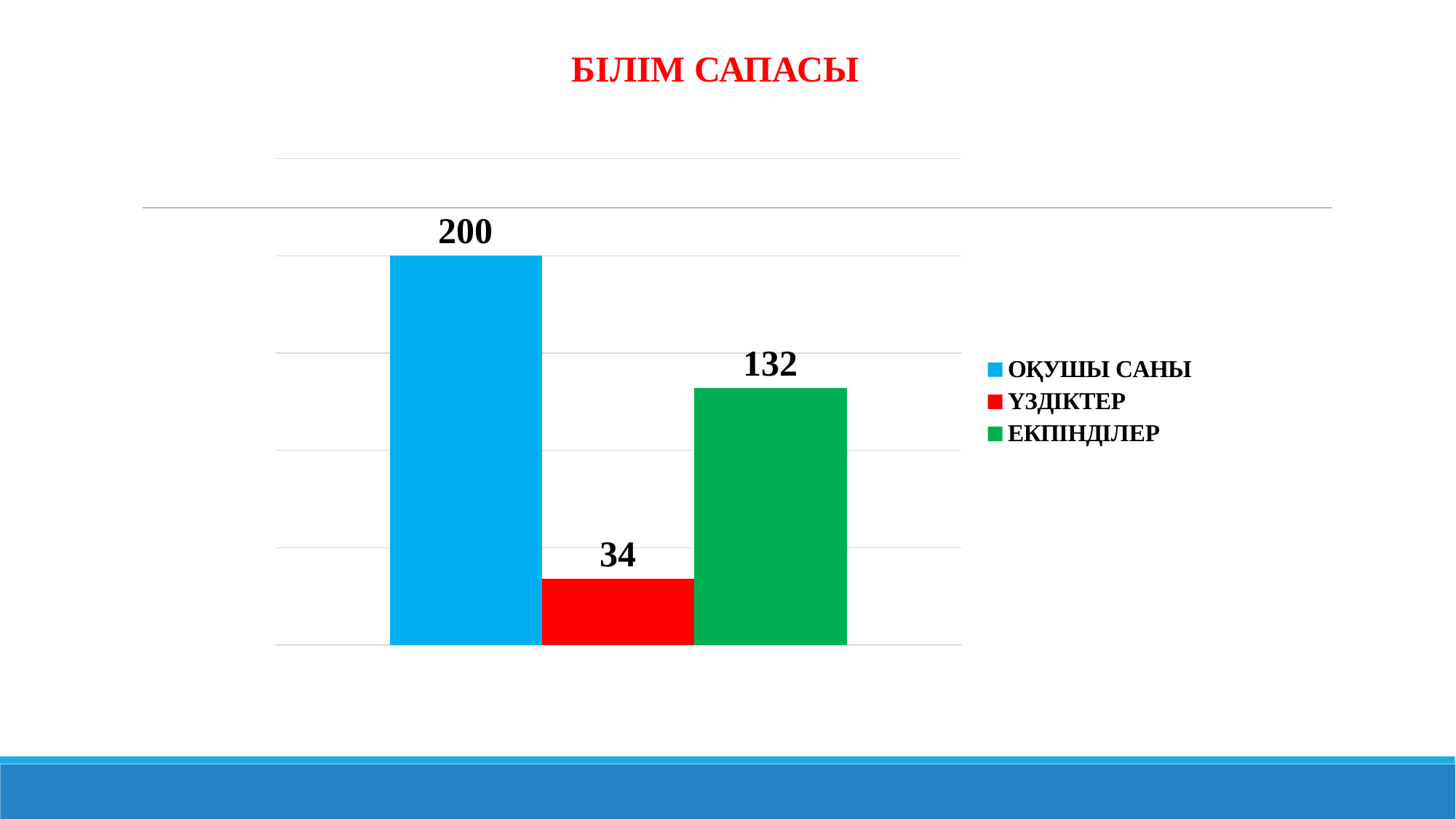
Which series has the lowest value? ҮЗДІКТЕР Which is larger, the value for ЕКПІНДІЛЕР or the value for ҮЗДІКТЕР? ЕКПІНДІЛЕР What kind of chart is shown on the slide? Bar chart How many series does the legend list? 3 What is the value for ОҚУШЫ САНЫ? 200 What is the value for ЕКПІНДІЛЕР? 132 What is the difference between the values for ОҚУШЫ САНЫ and ЕКПІНДІЛЕР? 68 What is the value for ҮЗДІКТЕР? 34 How many bars are plotted on the chart? 3 Which series has the highest value? ОҚУШЫ САНЫ What is the title of the slide? БІЛІМ САПАСЫ What is the difference between the values for ЕКПІНДІЛЕР and ҮЗДІКТЕР? 98